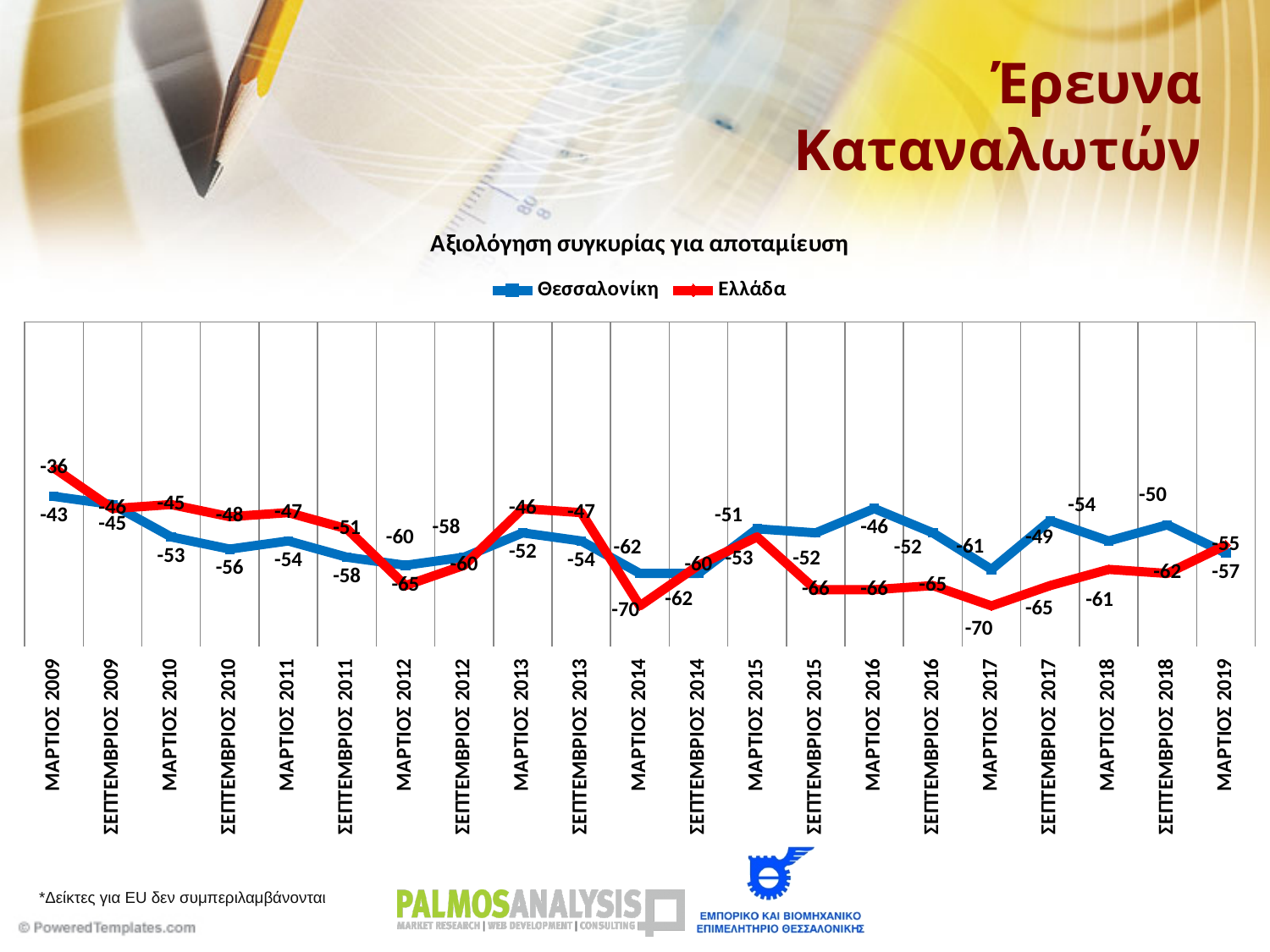
In which period does Ελλάδα reach its highest value? ΜΑΡΤΙΟΣ 2009 What is the value for Θεσσαλονίκη in ΜΑΡΤΙΟΣ 2016? -46 What is the value for Ελλάδα in ΜΑΡΤΙΟΣ 2019? -55 How many time periods are shown on the x axis? 21 Which series has the higher value in ΣΕΠΤΕΜΒΡΙΟΣ 2012? Θεσσαλονίκη How many series does the legend list? 2 Which series has the higher value in ΜΑΡΤΙΟΣ 2013? Ελλάδα What type of chart is shown? Line chart What is the value for Ελλάδα in ΜΑΡΤΙΟΣ 2009? -36 What is the difference between the Θεσσαλονίκη and Ελλάδα values in ΜΑΡΤΙΟΣ 2016? 20 In which period does Θεσσαλονίκη reach its highest value? ΜΑΡΤΙΟΣ 2009 What is the value for Θεσσαλονίκη in ΣΕΠΤΕΜΒΡΙΟΣ 2011? -58